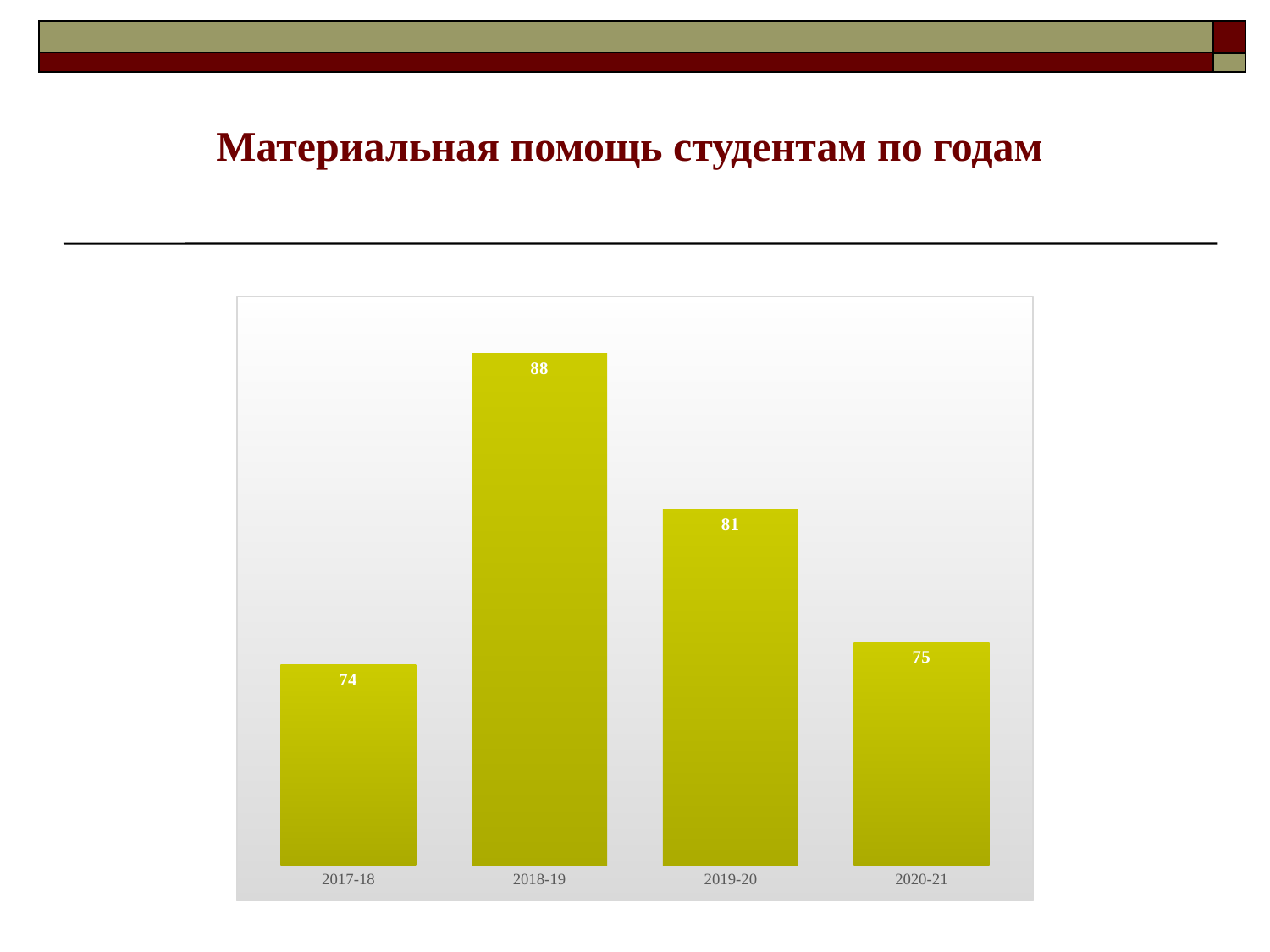
What is the value for 2019-20? 81 What kind of chart is shown on the slide? bar chart Which year has the lowest value? 2017-18 What is the difference between the values for 2018-19 and 2019-20? 7 Which year has the highest value? 2018-19 Which is larger, the value for 2019-20 or the value for 2020-21? 2019-20 How many years are shown on the chart? 4 What is the value for 2020-21? 75 What is the value for 2018-19? 88 What is the value for 2017-18? 74 What is the difference between the values for 2018-19 and 2017-18? 14 What is the title of the slide? Материальная помощь студентам по годам